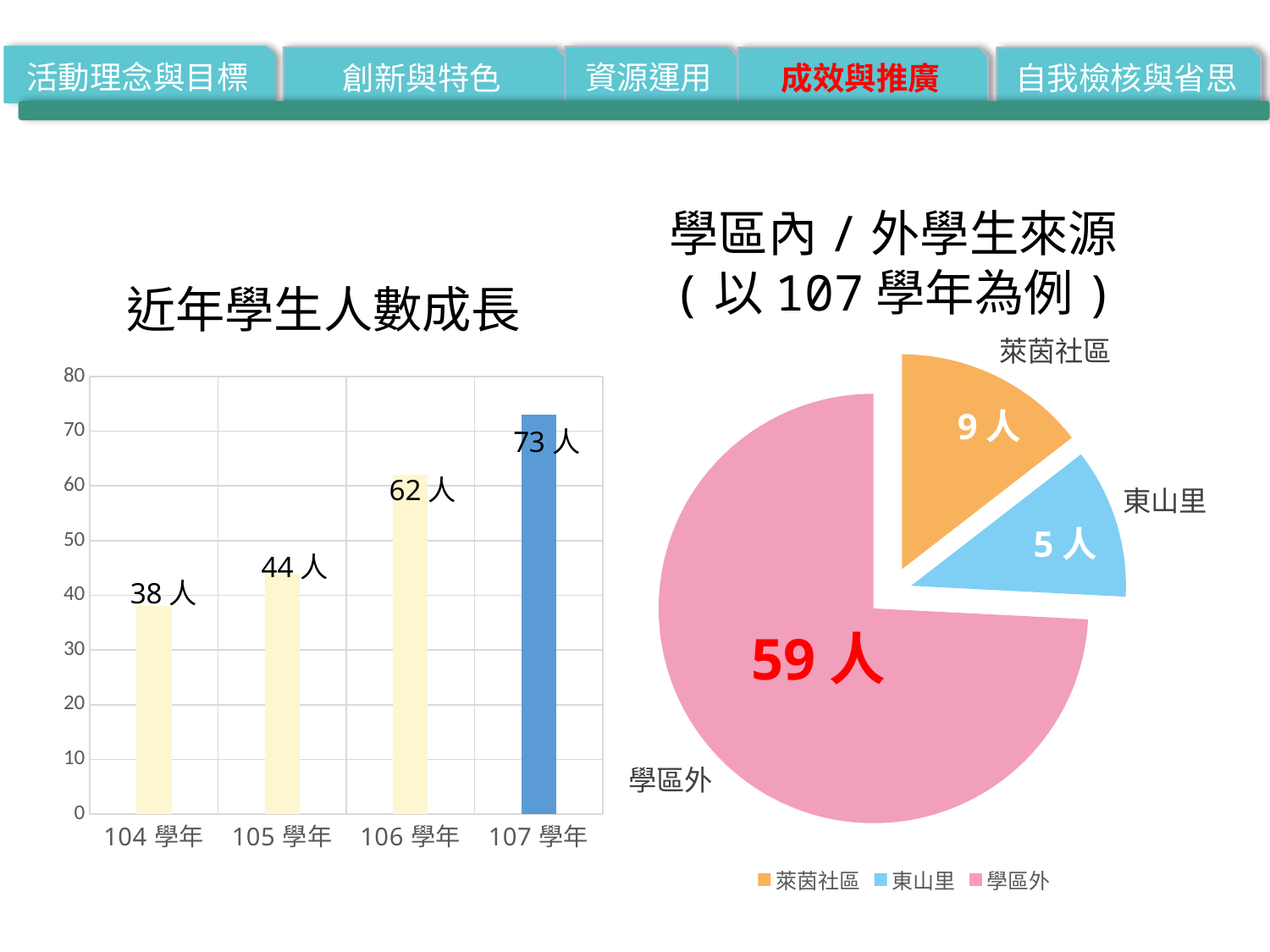
In the pie chart titled 學區內／外學生來源（以 107 學年為例）, which is larger, 萊茵社區 or 東山里? 萊茵社區 In the bar chart titled 近年學生人數成長, what is the value for 106 學年? 62 人 In the pie chart titled 學區內／外學生來源（以 107 學年為例）, which category has the largest slice? 學區外 In the bar chart titled 近年學生人數成長, what is the value for 104 學年? 38 人 What kind of chart is the chart titled 近年學生人數成長? bar chart In the pie chart titled 學區內／外學生來源（以 107 學年為例）, what is the value for 東山里? 5 人 In the bar chart titled 近年學生人數成長, how many years are shown on the x axis? 4 In the bar chart titled 近年學生人數成長, which year has the lowest value? 104 學年 In the pie chart titled 學區內／外學生來源（以 107 學年為例）, how many categories does the legend list? 3 In the bar chart titled 近年學生人數成長, do the values rise or fall from 104 學年 to 107 學年? rise In the bar chart titled 近年學生人數成長, what is the difference between the values for 107 學年 and 104 學年? 35 人 In the bar chart titled 近年學生人數成長, which year has the highest value? 107 學年